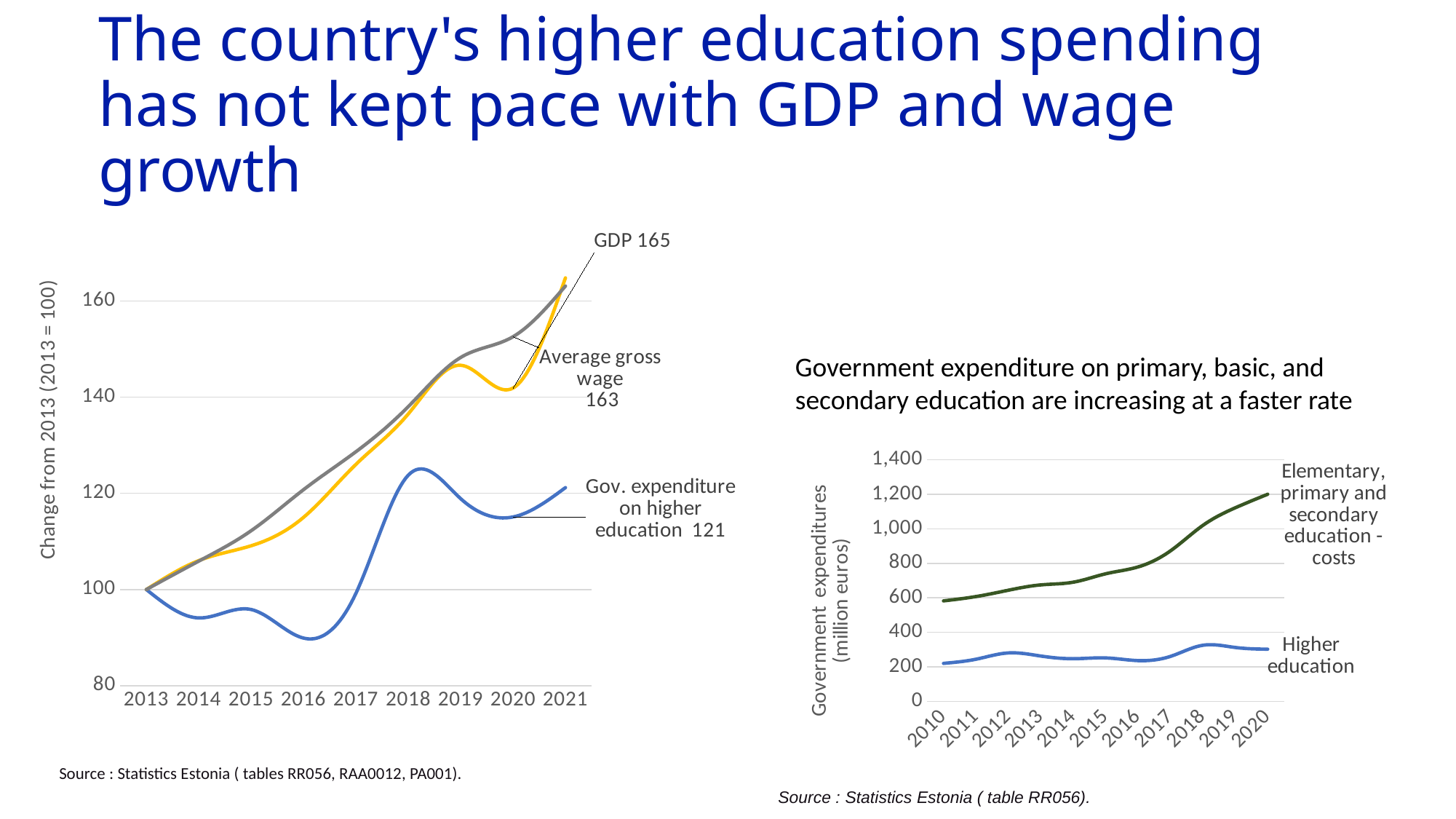
What kind of chart is the right chart, titled 'Government expenditure on primary, basic, and secondary education are increasing at a faster rate'? line chart On the left chart, what is the base year where all series equal 100? 2013 On the right chart, is the 2020 value for Higher education greater or less than 400? less On the left chart, which series has the highest value in 2021? GDP On the left chart, what is the 2021 value for Average gross wage? 163 On the right chart, how many years are shown on the x axis? 11 On the left chart, which series has the lowest value in 2021? Gov. expenditure on higher education On the left chart, what is the 2021 value for Gov. expenditure on higher education? 121 On the left chart, what is the difference between the 2021 values for GDP and Gov. expenditure on higher education? 44 On the right chart, is the 2020 value for Elementary, primary and secondary education costs greater or less than 1,000? greater On the left chart, how many years are shown on the x axis? 9 On the left chart, what is the 2021 value for GDP? 165